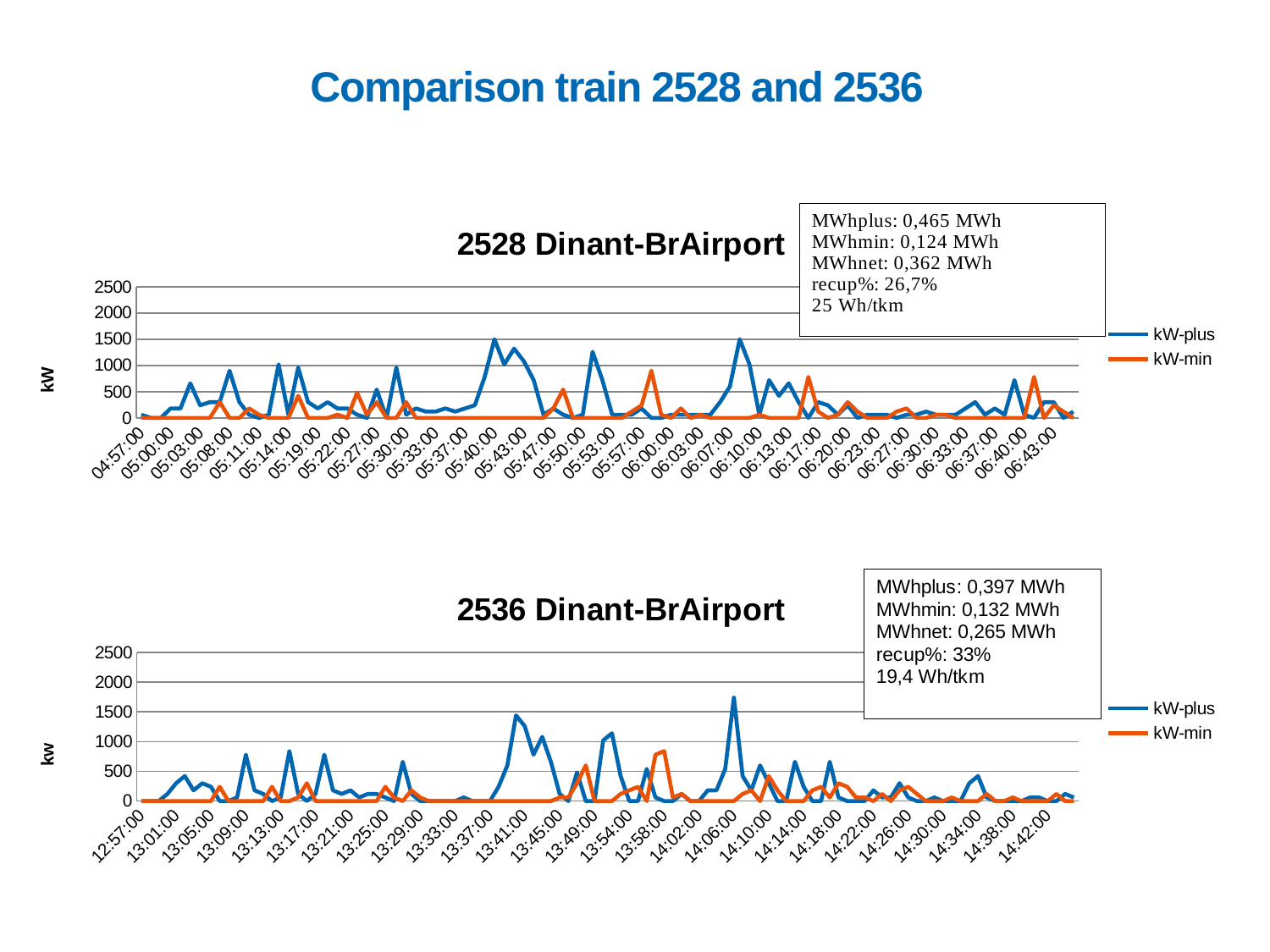
In the "2528 Dinant-BrAirport" chart, is the highest kW-plus value greater or less than 2000? less In the "2536 Dinant-BrAirport" chart, is the highest kW-plus value (near 14:06:00) greater or less than 1500? greater In the "2536 Dinant-BrAirport" chart, which series reaches the higher peak, kW-plus or kW-min? kW-plus In the "2536 Dinant-BrAirport" chart, is the highest kW-plus value greater or less than 2000? less What is the y-axis label of the "2536 Dinant-BrAirport" chart? kW Which chart shows the higher kW-plus peak, "2528 Dinant-BrAirport" or "2536 Dinant-BrAirport"? 2536 Dinant-BrAirport How many series does the legend of the "2536 Dinant-BrAirport" chart list? 2 What are the two legend entries in the "2528 Dinant-BrAirport" chart? kW-plus and kW-min What kind of chart is the "2528 Dinant-BrAirport" chart? line chart